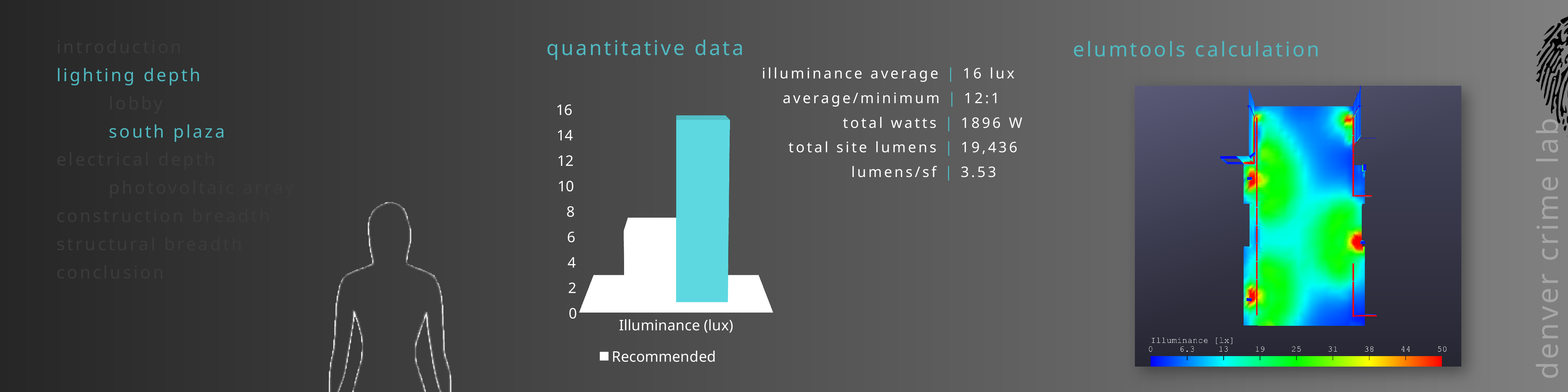
In the bar chart, is the teal bar greater or less than 10? greater How many series does the legend of the bar chart list? 1 In the bar chart, is the white Recommended bar greater or less than 10? less What series name appears in the legend of the bar chart? Recommended What is the category label on the x axis of the bar chart? Illuminance (lux) What is the highest value shown on the y axis of the bar chart? 16 How many categories are shown on the x axis of the bar chart? 1 What kind of chart is shown under the heading "quantitative data"? bar chart In the bar chart, is the teal bar greater or less than 14? greater In the bar chart, which bar is taller, the teal bar or the white Recommended bar? the teal bar